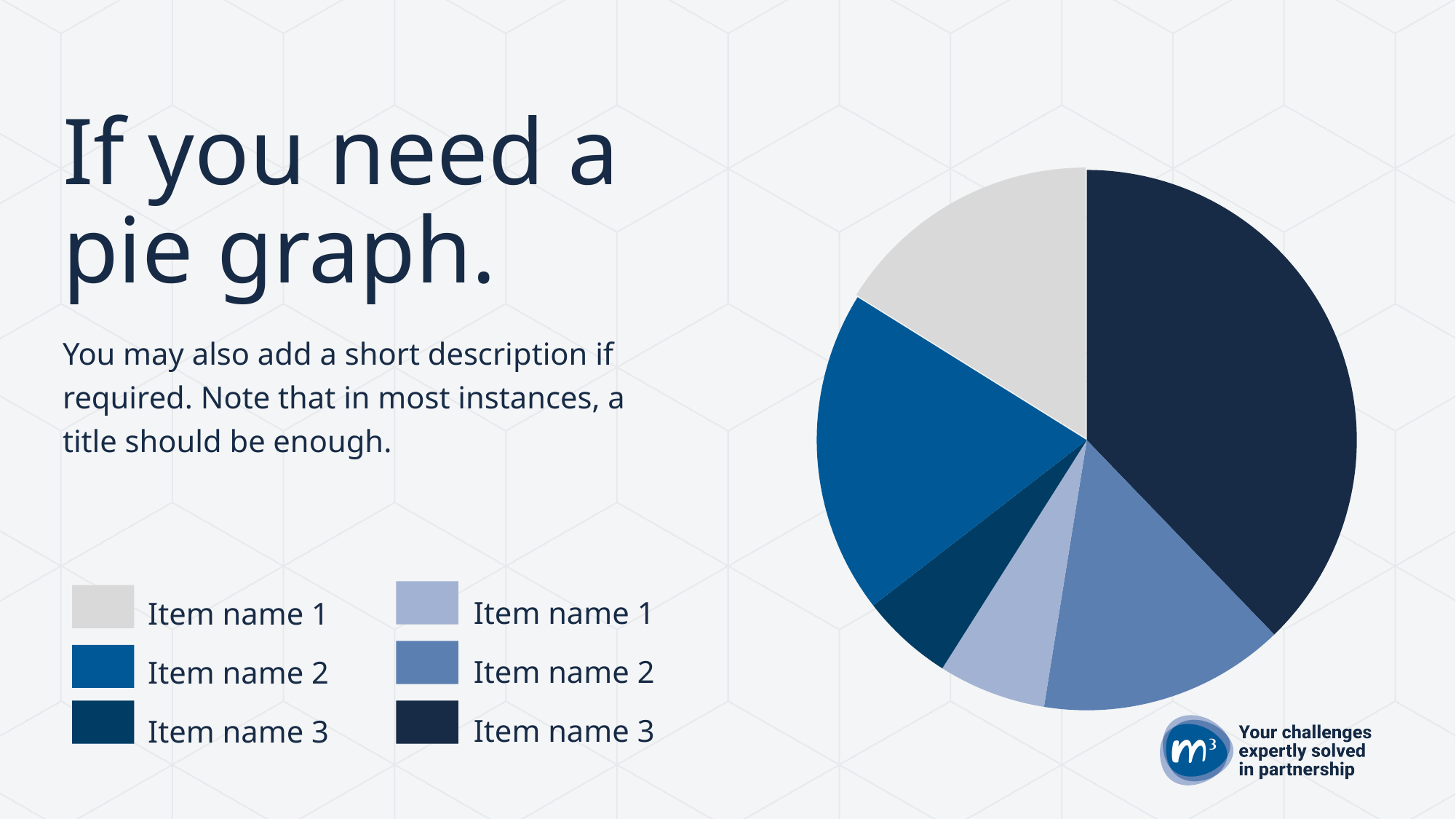
How many entries does the legend list? 6 What colour is the legend swatch for the first entry in the left legend column, Item name 1? light grey Which is larger: the dark navy slice or the light grey slice? the dark navy slice What is the title of the slide containing the pie chart? If you need a pie graph. Which slice of the pie chart is the largest? the dark navy slice (Item name 3, right legend column) How many slices does the pie chart have? 6 Which is larger: the medium blue slice (Item name 2, left legend column) or the light lavender slice (Item name 1, right legend column)? the medium blue slice What kind of chart is shown on the slide? pie chart